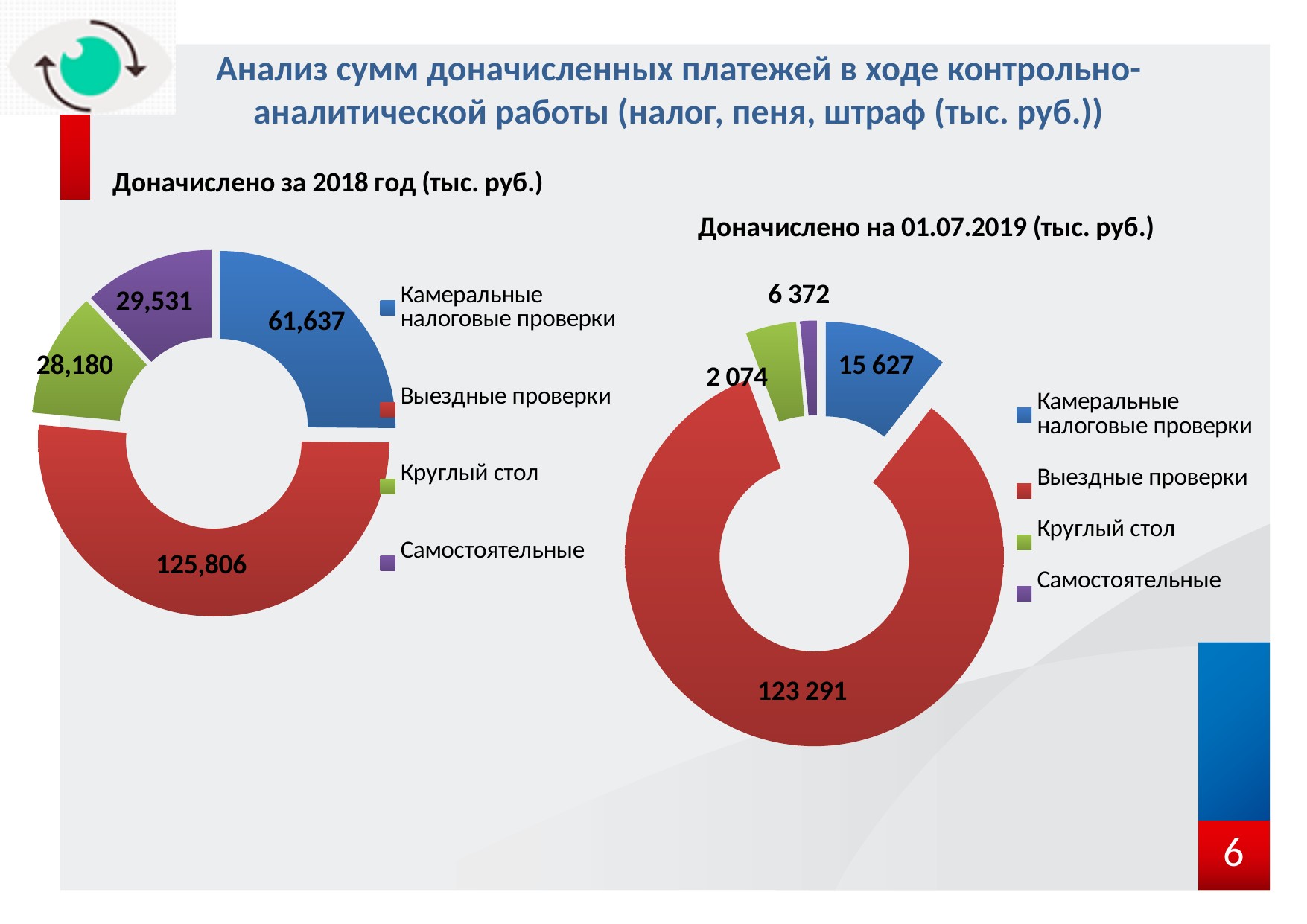
In the chart 'Доначислено за 2018 год (тыс. руб.)', what is the difference between Выездные проверки and Камеральные налоговые проверки? 64,169 How many categories does the legend of the chart 'Доначислено на 01.07.2019 (тыс. руб.)' list? 4 In the chart 'Доначислено за 2018 год (тыс. руб.)', what is the value for Камеральные налоговые проверки? 61,637 In the chart 'Доначислено за 2018 год (тыс. руб.)', which category has the largest value? Выездные проверки In the chart 'Доначислено за 2018 год (тыс. руб.)', what is the value for Круглый стол? 28,180 In the chart 'Доначислено на 01.07.2019 (тыс. руб.)', what is the value for Камеральные налоговые проверки? 15 627 In the chart 'Доначислено за 2018 год (тыс. руб.)', which category has the smallest value? Круглый стол In the chart 'Доначислено на 01.07.2019 (тыс. руб.)', which category has the largest value? Выездные проверки What kind of chart is used on this slide for the 2018 data? Doughnut (pie) chart In the chart 'Доначислено за 2018 год (тыс. руб.)', what is the value for Выездные проверки? 125,806 In the chart 'Доначислено на 01.07.2019 (тыс. руб.)', what is the value for Выездные проверки? 123 291 In the chart 'Доначислено за 2018 год (тыс. руб.)', what is the value for Самостоятельные? 29,531